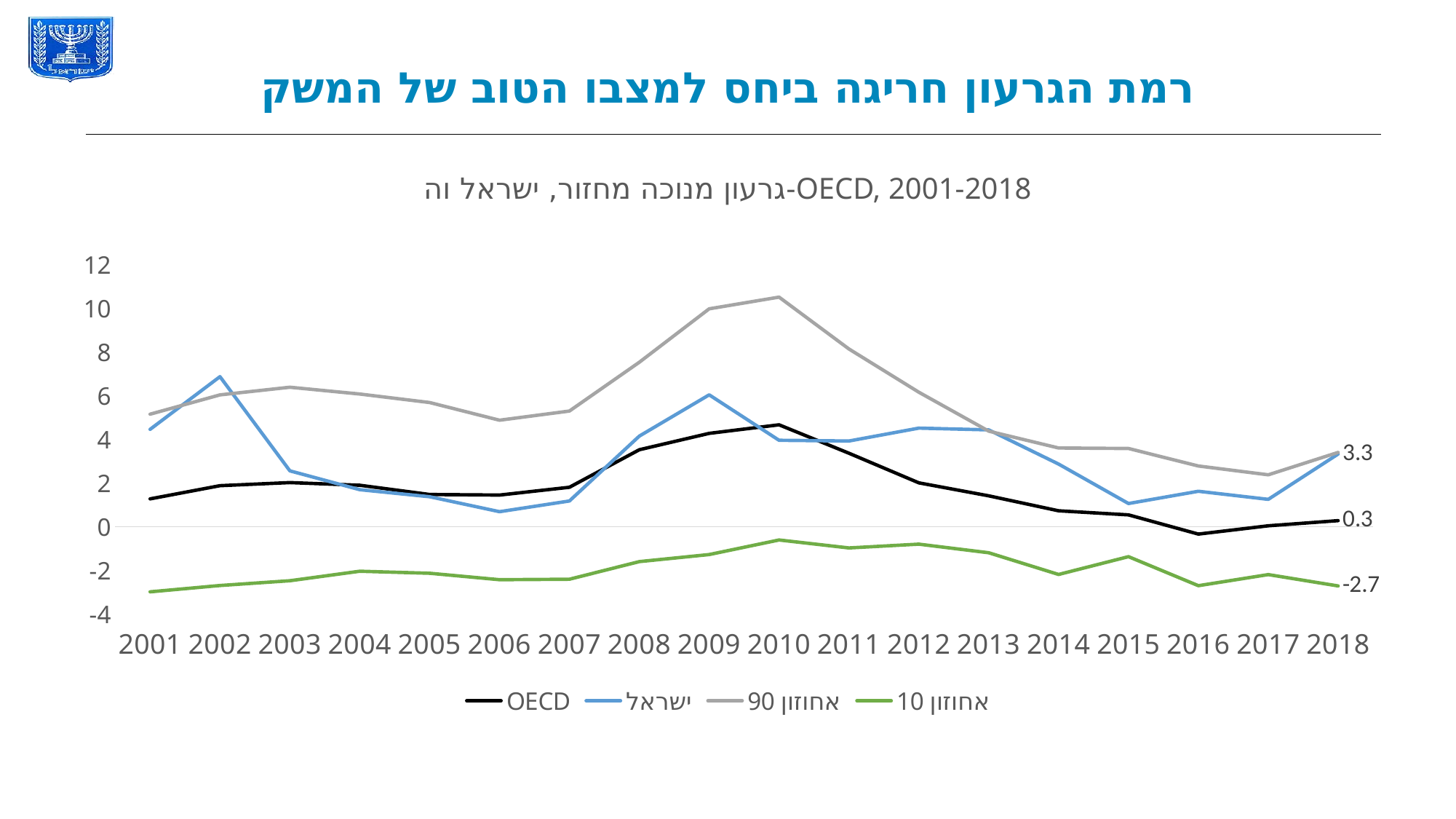
Is the value for ישראל in 2002 greater or less than 6? greater How many series does the legend list? 4 In 2009, which is higher, the ישראל line or the OECD line? ישראל Is the value for אחוזון 90 in 2010 greater or less than 10? greater In which year does the ישראל line reach its highest value? 2002 How many years are shown on the x axis? 18 What is the value of the OECD line in 2018? 0.3 What is the value of the אחוזון 10 line in 2018? -2.7 In which year is the OECD line at its lowest? 2016 In which year does the אחוזון 90 line reach its highest value? 2010 What kind of chart is shown on the slide? line chart What is the difference between the OECD value and the אחוזון 10 value in 2018? 3.0